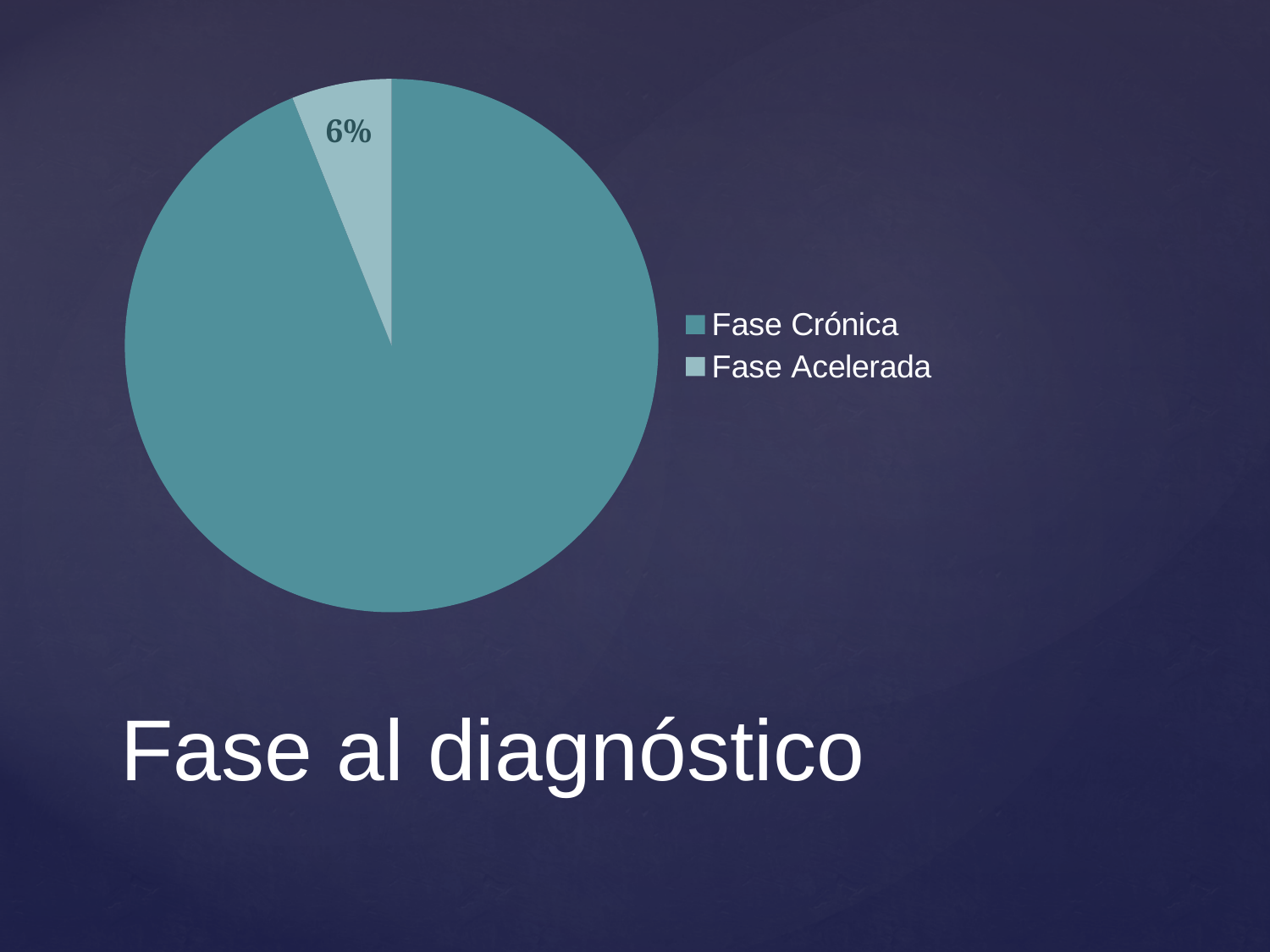
How many entries does the legend of the pie chart list? 2 Which category has the smallest slice of the pie? Fase Acelerada What is the title shown on the slide with the pie chart? Fase al diagnóstico Which category has the largest slice of the pie? Fase Crónica What share of the pie does Fase Acelerada represent? 6% Which is larger, the Fase Crónica slice or the Fase Acelerada slice? Fase Crónica What percentage is shown for the Fase Acelerada slice? 6% What kind of chart is shown on the slide? Pie chart What are the two categories listed in the legend of the pie chart? Fase Crónica and Fase Acelerada How many slices does the pie chart have? 2